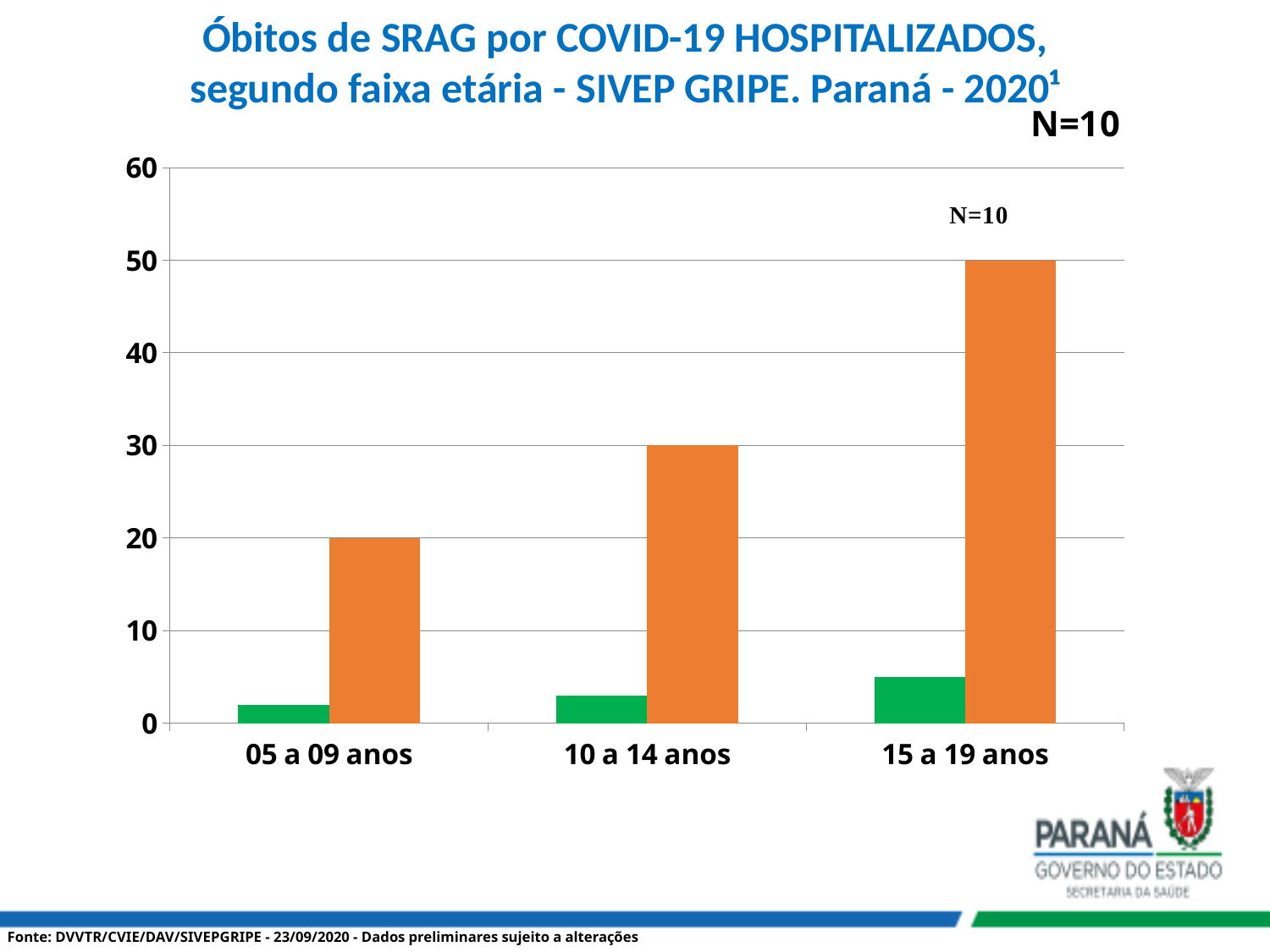
Which age group has the lowest orange bar? 05 a 09 anos Do the orange bars rise or fall from 05 a 09 anos to 15 a 19 anos? rise Is the value of the green bar for 15 a 19 anos greater or less than 10? less What is the value of the orange bar for 05 a 09 anos? 20 How many age-group categories are shown on the x axis? 3 Which age group has the highest orange bar? 15 a 19 anos What is the value of the orange bar for 10 a 14 anos? 30 Which has the larger orange bar, 10 a 14 anos or 05 a 09 anos? 10 a 14 anos What N value is printed on the chart? N=10 What is the difference between the orange bar for 15 a 19 anos and the orange bar for 05 a 09 anos? 30 What is the value of the orange bar for 15 a 19 anos? 50 What kind of chart is shown on the slide? bar chart